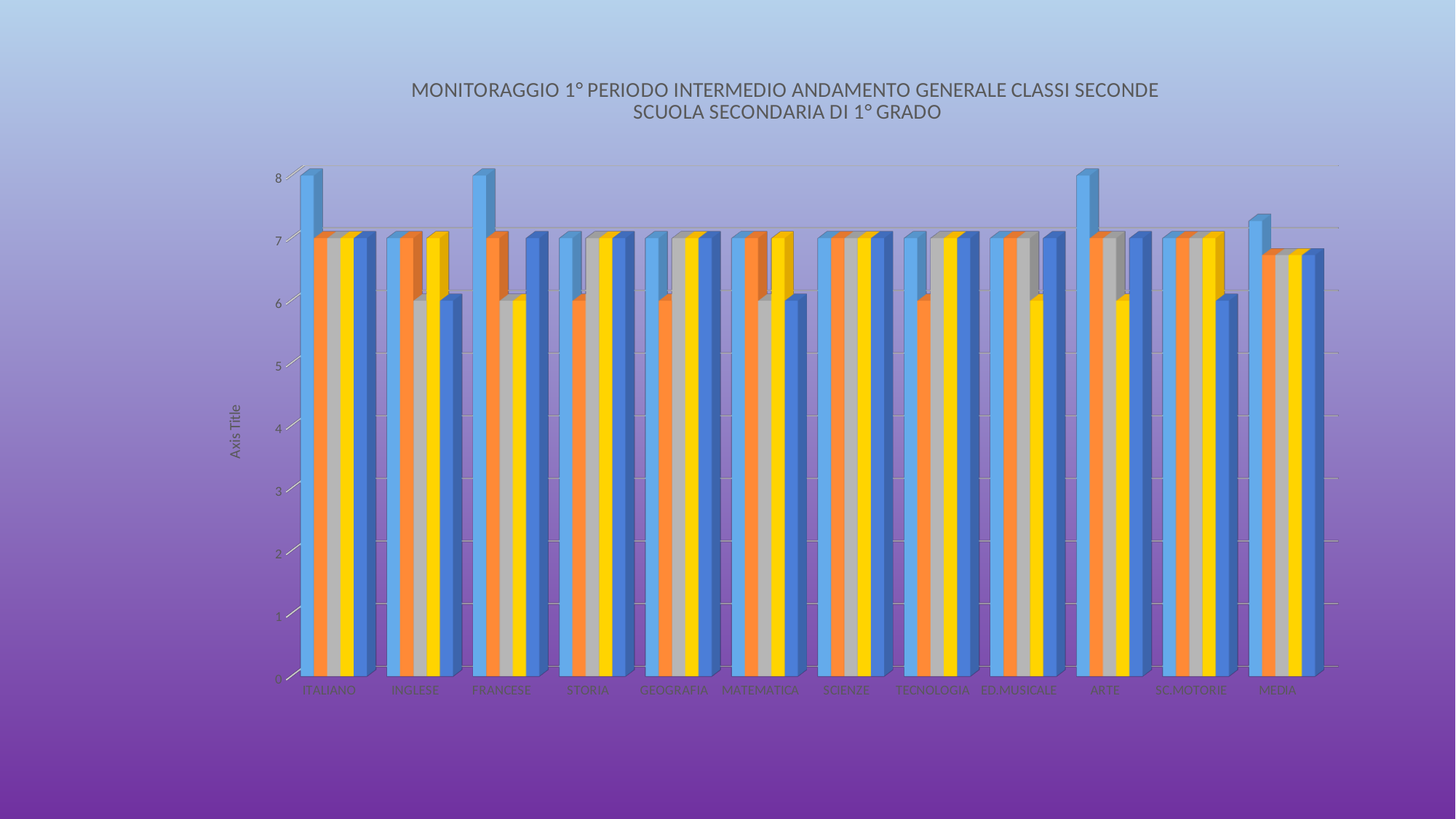
Are the bars for TECNOLOGIA greater or less than 5? greater What label is shown on the vertical axis of the chart? Axis Title What is the last category on the horizontal axis of the chart? MEDIA Is the lowest bar in the chart greater or less than 5? greater What kind of chart is shown on the slide? bar chart What is the title of the chart? MONITORAGGIO 1° PERIODO INTERMEDIO ANDAMENTO GENERALE CLASSI SECONDE SCUOLA SECONDARIA DI 1° GRADO How many categories are shown along the horizontal axis of the chart? 12 What is the first category on the horizontal axis of the chart? ITALIANO Are the bars for SCIENZE greater or less than 6? greater What is the highest tick value shown on the vertical axis? 8 How many bars are plotted for each category in the chart? 5